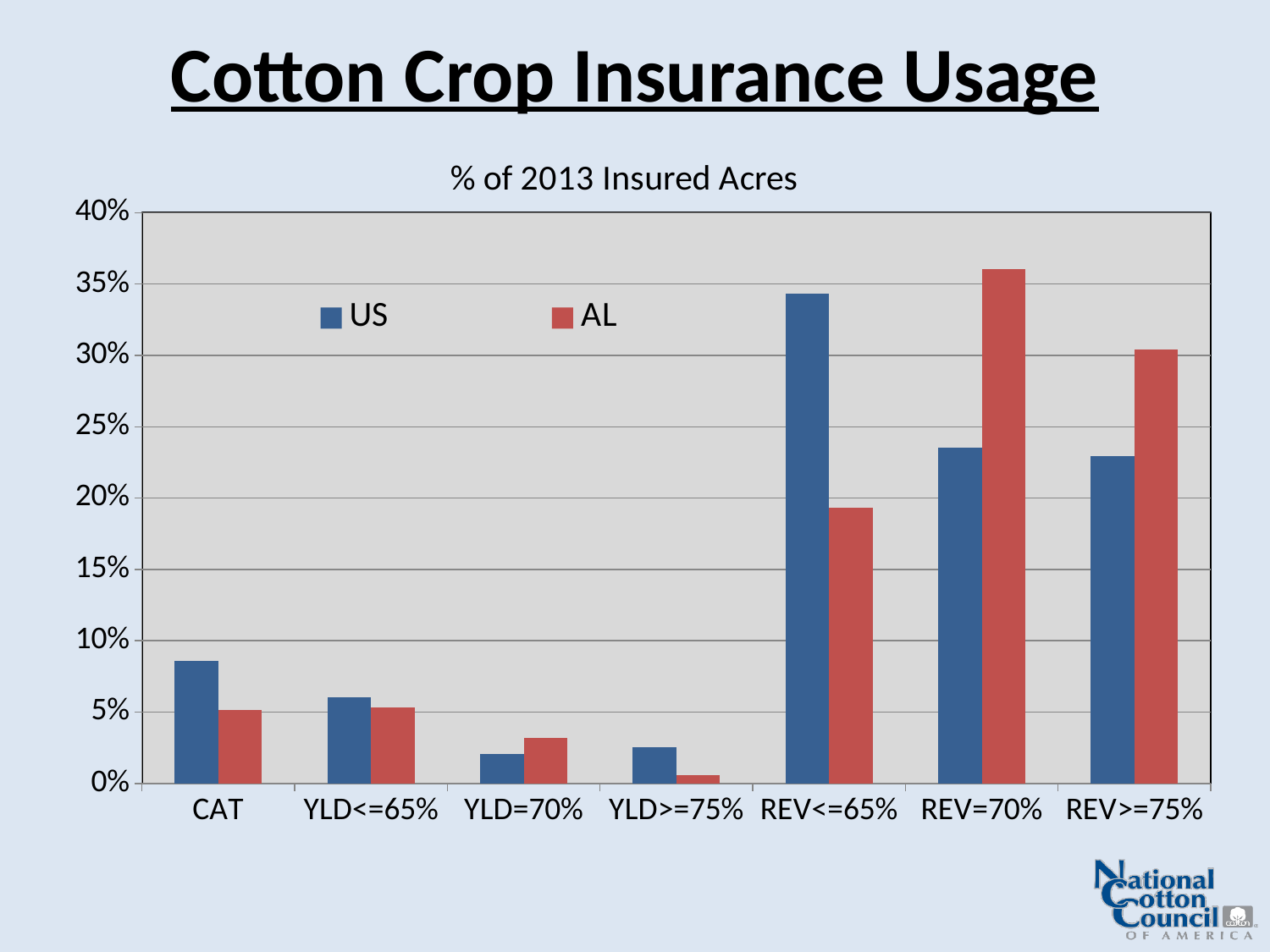
Which category has the lowest US value? YLD=70% Is the AL value for REV<=65% greater or less than 20%? less How many series does the legend list? 2 What kind of chart is shown on the slide? bar chart Is the US value for REV<=65% greater or less than 30%? greater For REV=70%, which is larger, the US value or the AL value? AL How many categories are shown on the x axis? 7 Which category has the highest US value? REV<=65% Which category has the lowest AL value? YLD>=75% For CAT, which is larger, the US value or the AL value? US Which category has the highest AL value? REV=70% What is the subtitle shown above the chart? % of 2013 Insured Acres